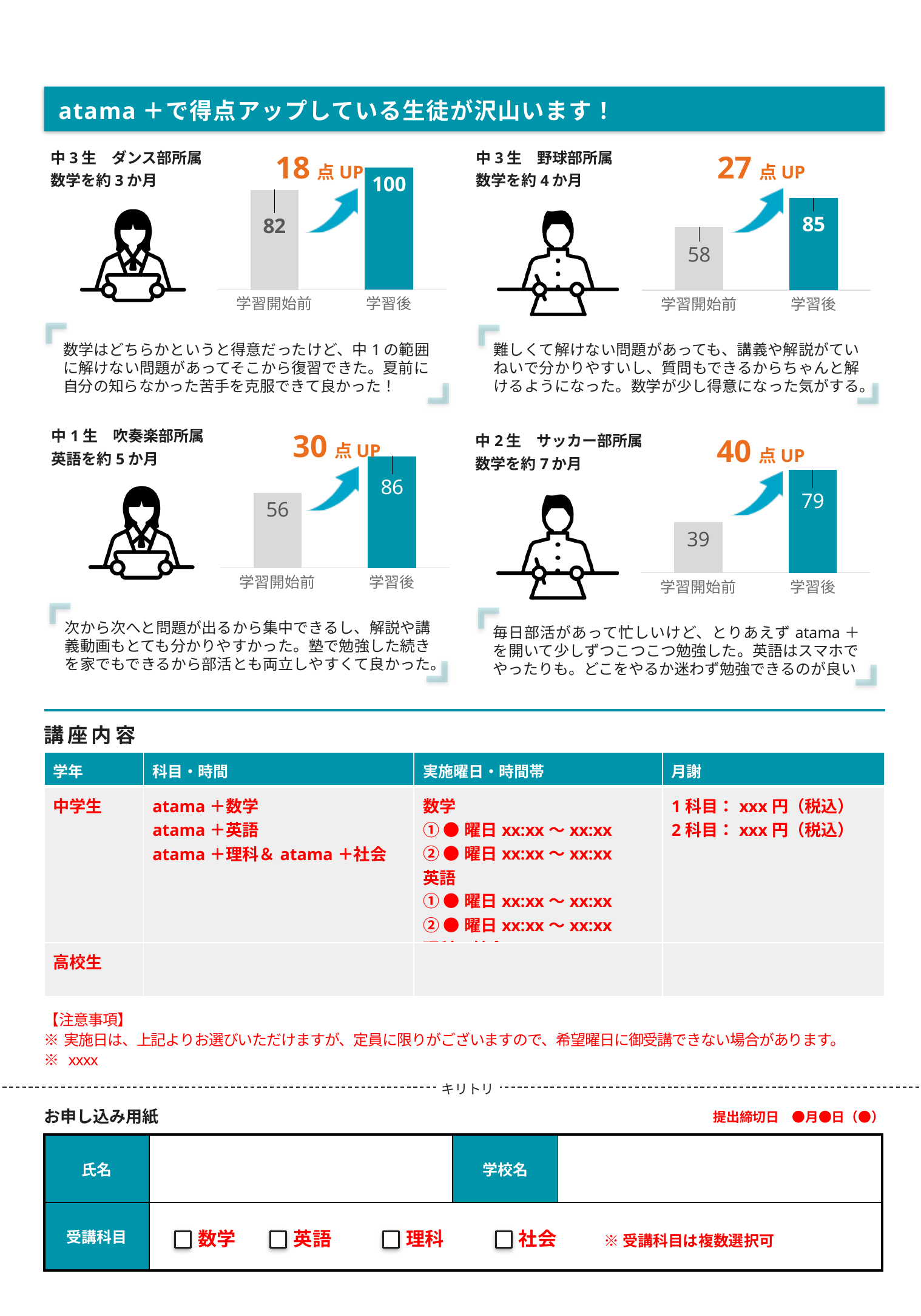
In the top-right chart (中3生 野球部所属), what is the value for 学習開始前? 58 In the top-right chart (中3生 野球部所属), what is the difference between 学習後 and 学習開始前? 27 In the bottom-left chart (中1生 吹奏楽部所属), what is the difference between 学習後 and 学習開始前? 30 In the bottom-left chart (中1生 吹奏楽部所属), what is the value for 学習後? 86 In the top-left chart (中3生 ダンス部所属), what is the value for 学習開始前? 82 In the bottom-left chart (中1生 吹奏楽部所属), do the values rise or fall from 学習開始前 to 学習後? rise How many bars does the top-right chart (中3生 野球部所属) have? 2 In the bottom-right chart (中2生 サッカー部所属), what is the value for 学習後? 79 In the bottom-right chart (中2生 サッカー部所属), what is the value for 学習開始前? 39 In the bottom-right chart (中2生 サッカー部所属), which bar is higher, 学習開始前 or 学習後? 学習後 In the top-left chart (中3生 ダンス部所属), what is the value for 学習後? 100 What kind of chart is the top-left chart (中3生 ダンス部所属)? bar chart